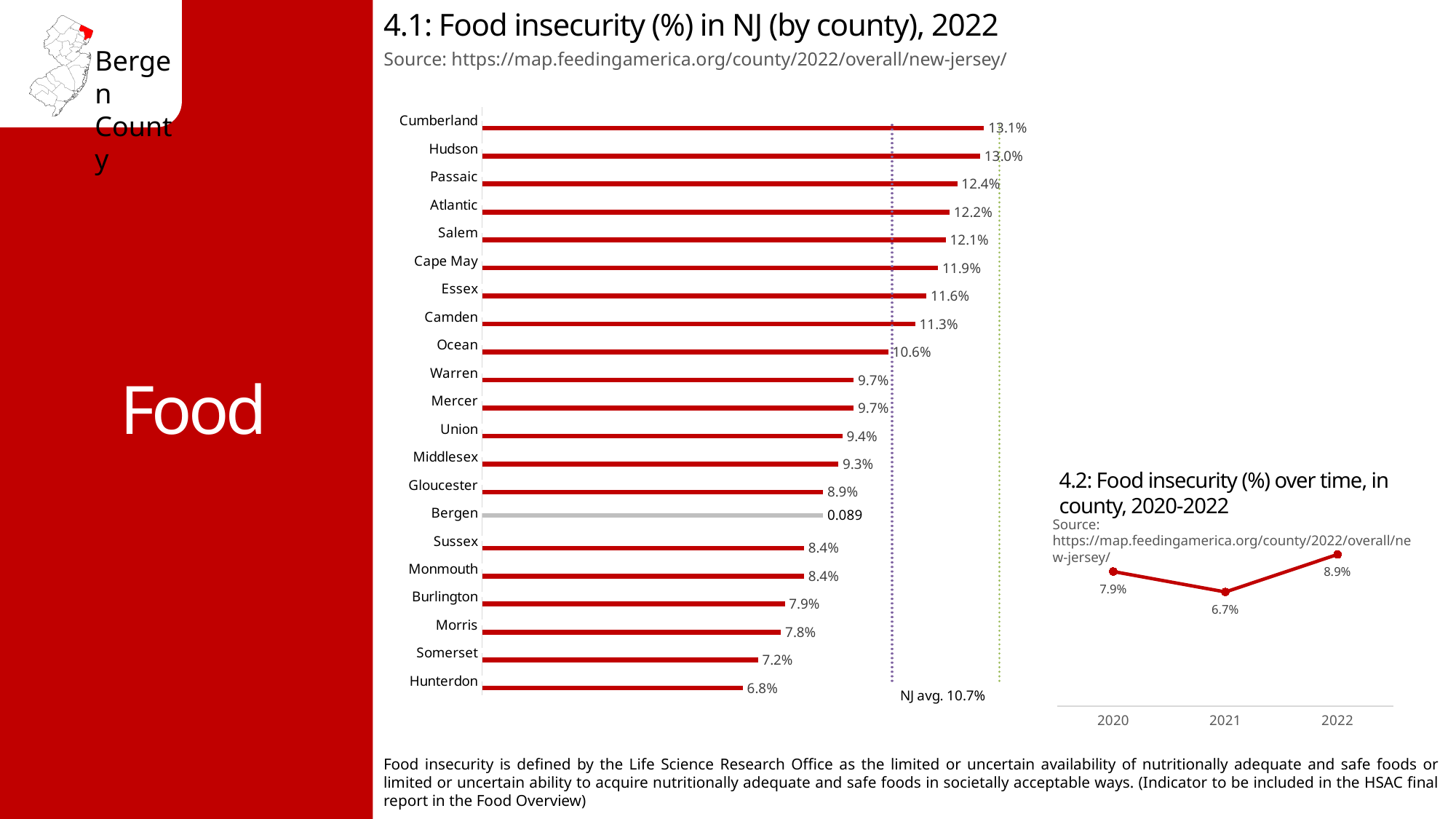
In chart 4.1 (Food insecurity in NJ by county, 2022), what is the value for Essex? 11.6% In chart 4.1 (Food insecurity in NJ by county, 2022), which county has the highest value? Cumberland In chart 4.1 (Food insecurity in NJ by county, 2022), which is larger, Camden or Union? Camden What kind of chart is chart 4.2 (Food insecurity over time in county, 2020-2022)? line chart In chart 4.2 (Food insecurity over time in county, 2020-2022), what is the difference between 2022 and 2020? 1.0% In chart 4.1 (Food insecurity in NJ by county, 2022), what label is printed on the Bergen bar? 0.089 In chart 4.1 (Food insecurity in NJ by county, 2022), what is the difference between Passaic and Somerset? 5.2% In chart 4.2 (Food insecurity over time in county, 2020-2022), what is the value for 2021? 6.7% In chart 4.1 (Food insecurity in NJ by county, 2022), which county has the lowest value? Hunterdon In chart 4.1 (Food insecurity in NJ by county, 2022), what NJ average is marked by the dotted line? 10.7% In chart 4.1 (Food insecurity in NJ by county, 2022), what is the value for Cumberland? 13.1% In chart 4.1 (Food insecurity in NJ by county, 2022), how many counties are plotted? 21